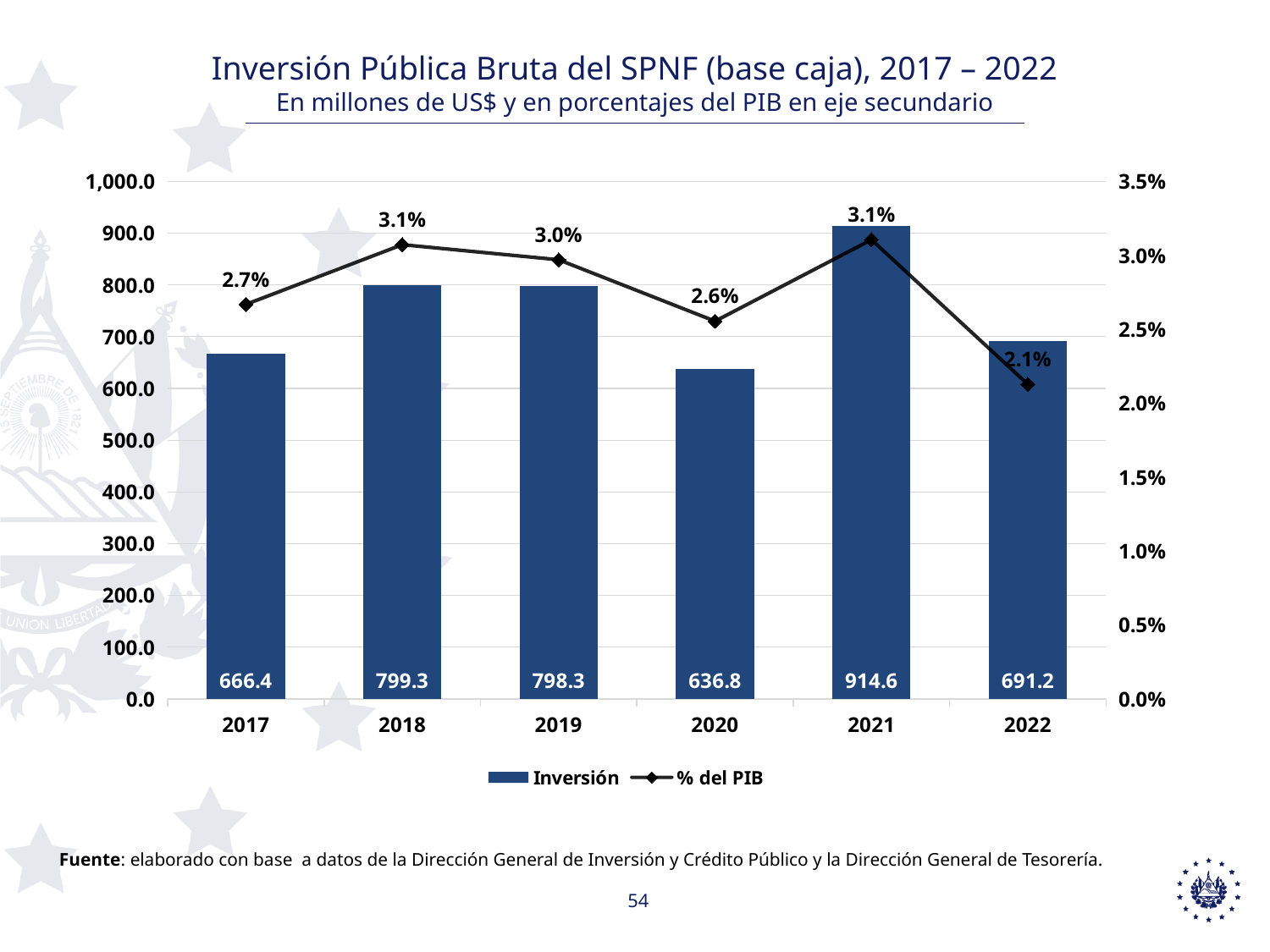
What is the Inversión value for 2021? 914.6 Which is larger, the Inversión value for 2021 or for 2018? 2021 Is the Inversión value for 2017 greater or less than 700.0? less What is the difference between the Inversión values for 2021 and 2020? 277.8 What is the Inversión value for 2017? 666.4 What is the % del PIB value for 2020? 2.6% How many years are shown on the x axis? 6 Which year has the highest Inversión bar? 2021 Which year has the lowest % del PIB value? 2022 Does the % del PIB value rise or fall from 2021 to 2022? fall How many series does the legend list? 2 Which year has the lowest Inversión bar? 2020